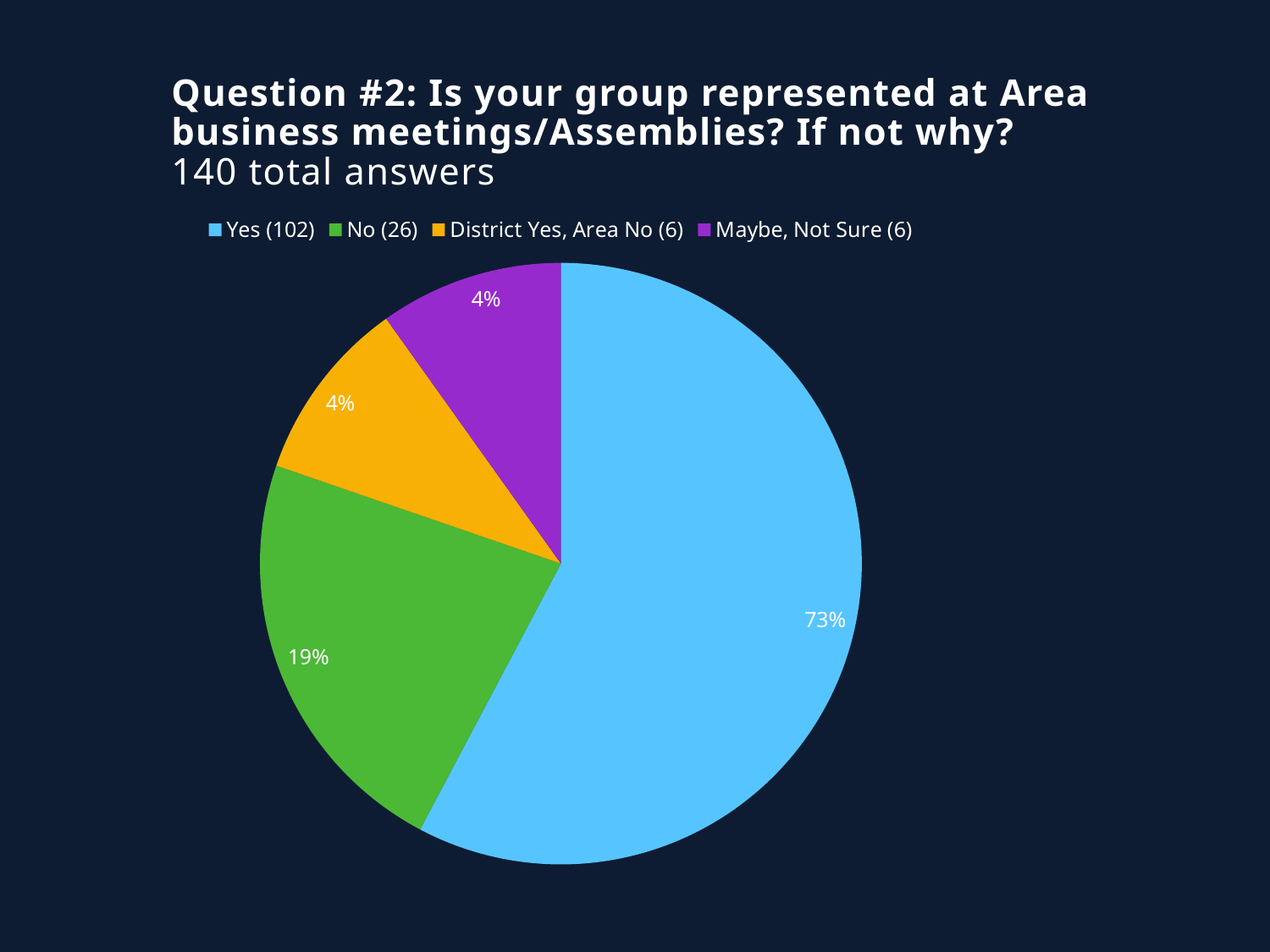
What percentage of the pie does the "Yes" slice represent? 73% Which category has the largest slice of the pie? Yes How many answers does the legend show for the "No" category? 26 What percentage is shown for the "District Yes, Area No" slice? 4% How many categories does the legend list? 4 What is the difference in percentage points between the "Yes" slice and the "No" slice? 54 What percentage is shown for the "Maybe, Not Sure" slice? 4% What kind of chart is shown on the slide? Pie chart What percentage of the pie does the "No" slice represent? 19% What colour is the "Yes" slice? Light blue Which slice is larger, "No" or "Maybe, Not Sure"? No How many answers does the legend show for the "Yes" category? 102